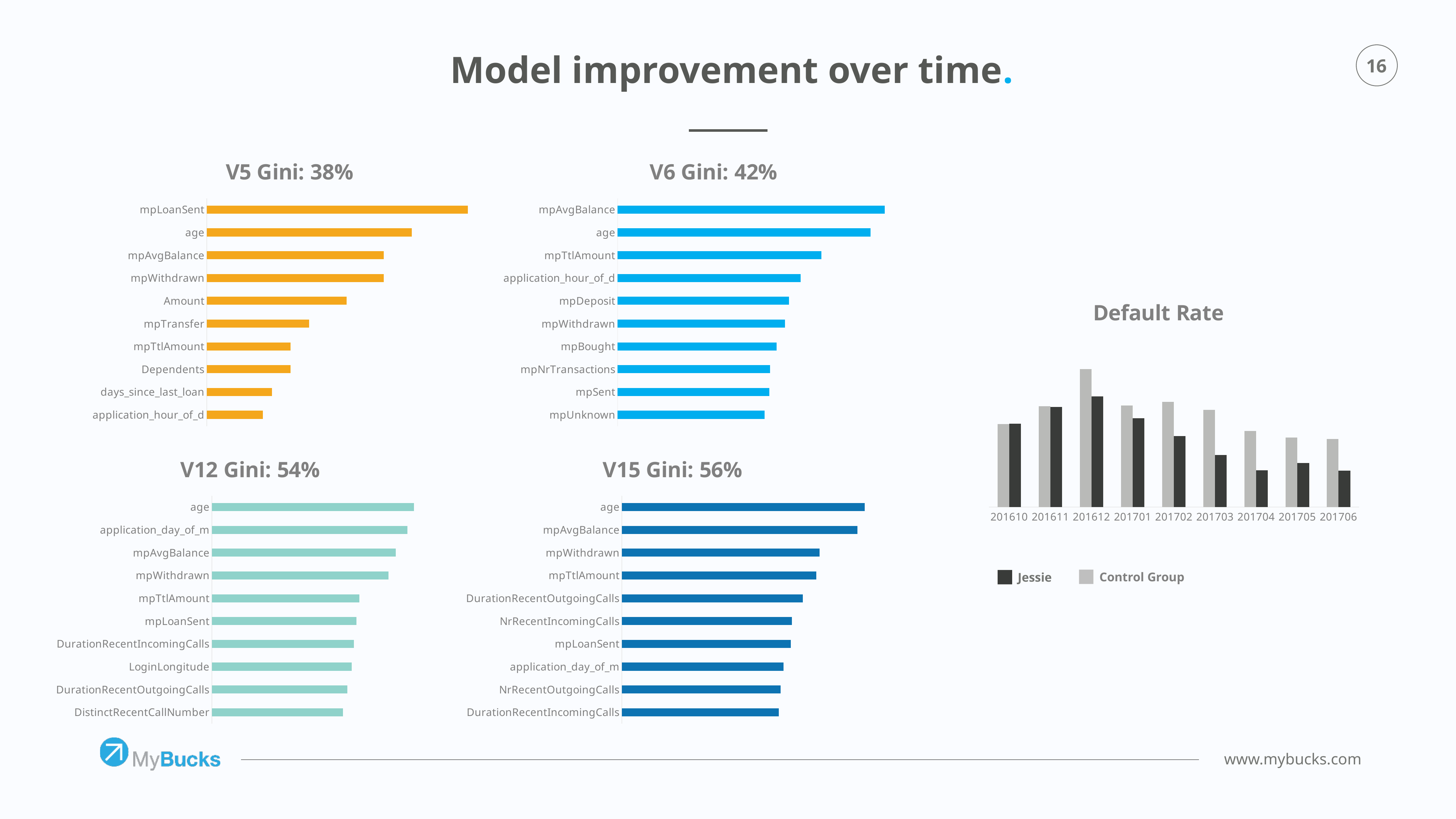
How many series does the legend of the Default Rate chart list? 2 In the V6 Gini: 42% chart, which category has the longest bar? mpAvgBalance How many periods are shown on the x axis of the Default Rate chart? 9 How many categories are shown in the V6 Gini: 42% chart? 10 In the V12 Gini: 54% chart, which category has the longest bar? age In the Default Rate chart, which period has the highest Control Group bar? 201612 In the V12 Gini: 54% chart, which category has the shortest bar? DistinctRecentCallNumber What kind of chart is the V5 Gini: 38% chart? bar chart In the V5 Gini: 38% chart, which category has the shortest bar? application_hour_of_d In the Default Rate chart, for 201706, which is larger: Jessie or Control Group? Control Group